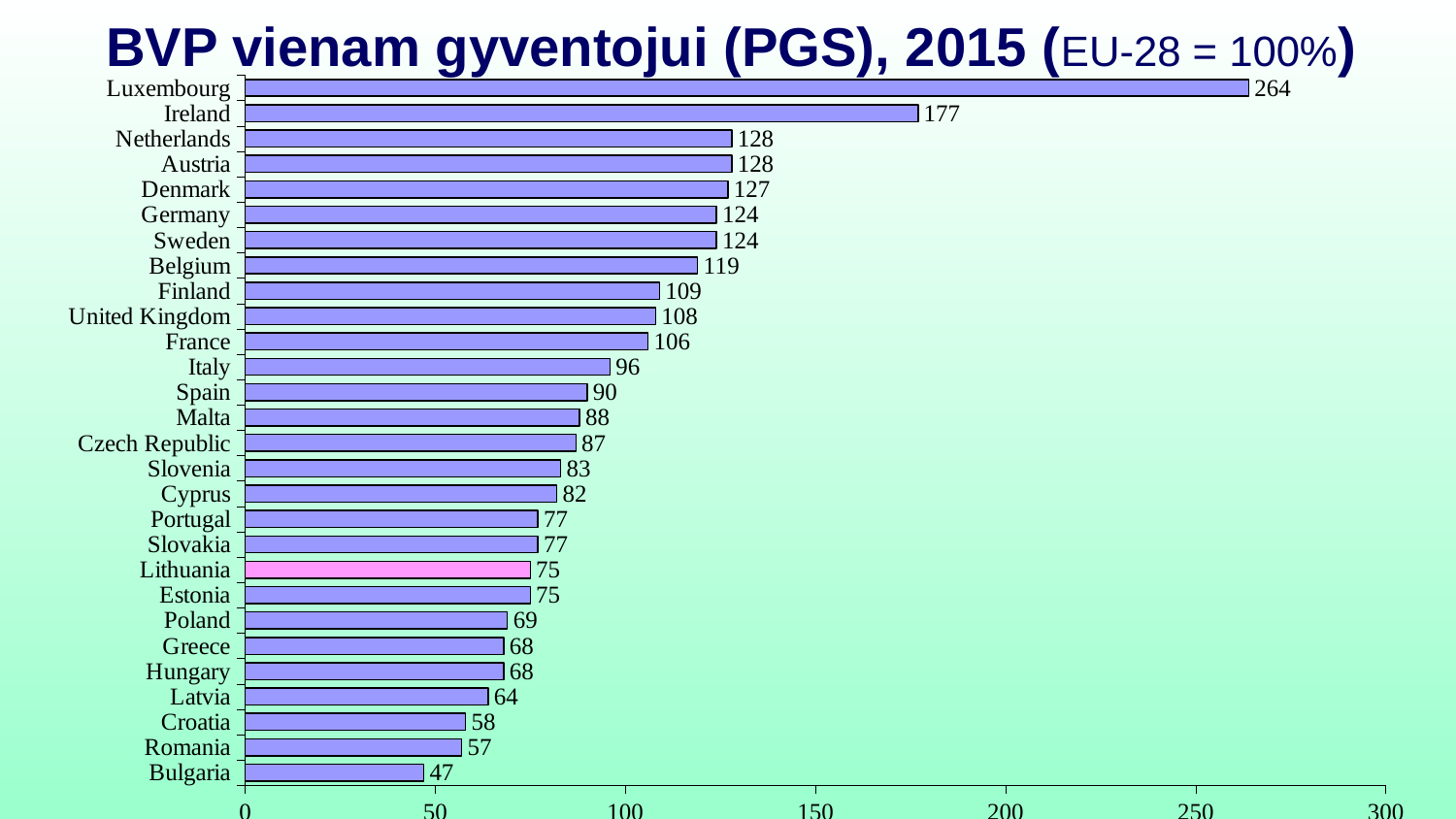
What kind of chart is shown on the slide? bar chart What is the value for Luxembourg? 264 What is the value for Czech Republic? 87 Which is larger, the value for Finland or the value for Italy? Finland What is the value for Lithuania? 75 Is the value for Ireland greater or less than 150? greater Which country has the lowest value? Bulgaria What is the difference between the values for Luxembourg and Ireland? 87 How many countries are shown in the chart? 28 Which country's bar is highlighted in a different colour (pink) from the others? Lithuania Which country has the highest value? Luxembourg What is the difference between the values for Lithuania and Bulgaria? 28